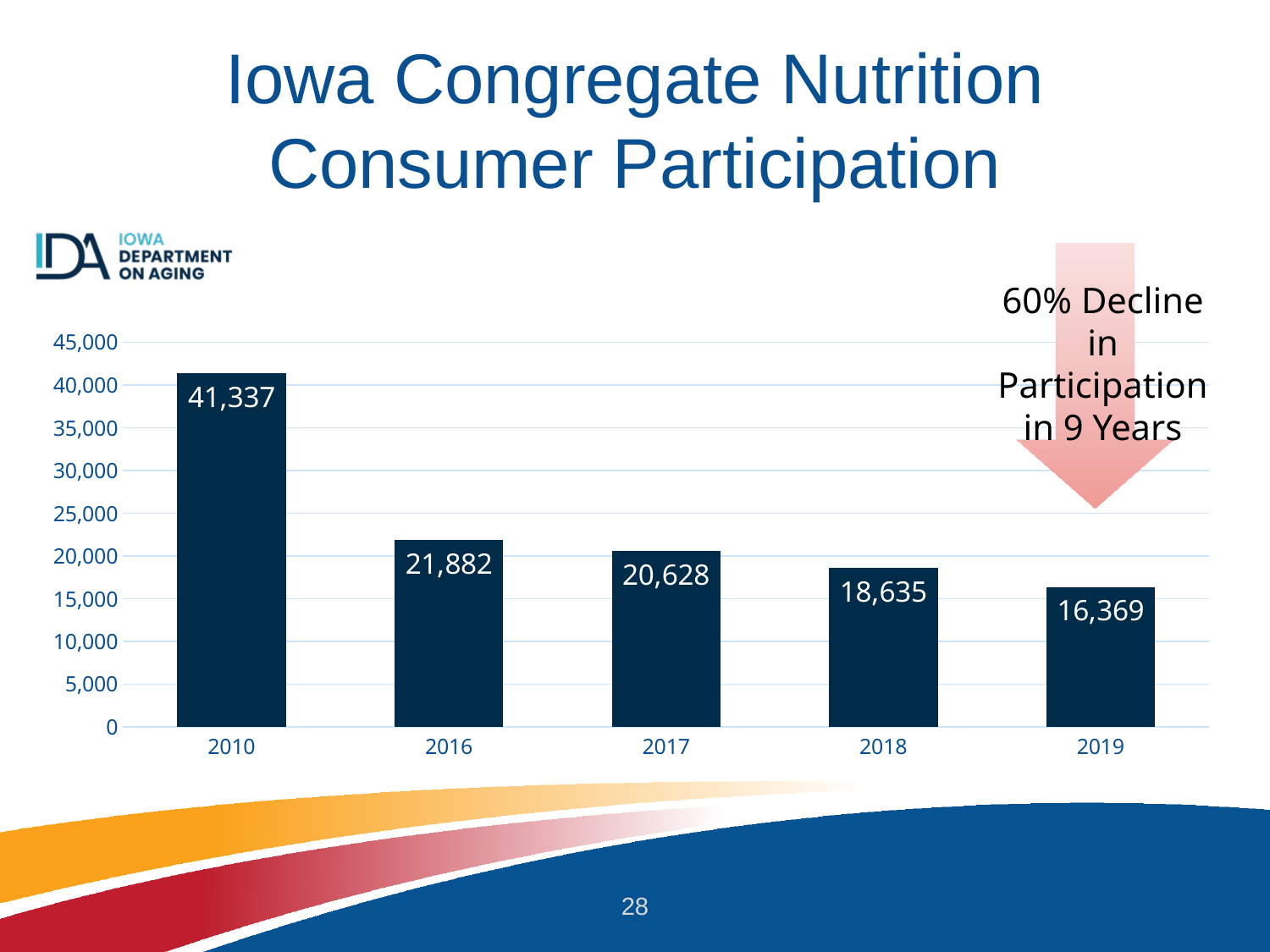
Do the participation values rise or fall from 2010 to 2019? Fall Is the value for 2018 greater or less than 20,000? less How many years are shown on the chart? 5 Which year had the highest participation? 2010 What was the consumer participation in 2017? 20,628 Which year had higher participation, 2018 or 2016? 2016 What kind of chart is shown on the slide? Bar chart Which year had the lowest participation? 2019 What is the difference in participation between 2016 and 2017? 1,254 What was the consumer participation in 2010? 41,337 What was the consumer participation in 2019? 16,369 What is the difference in participation between 2010 and 2019? 24,968